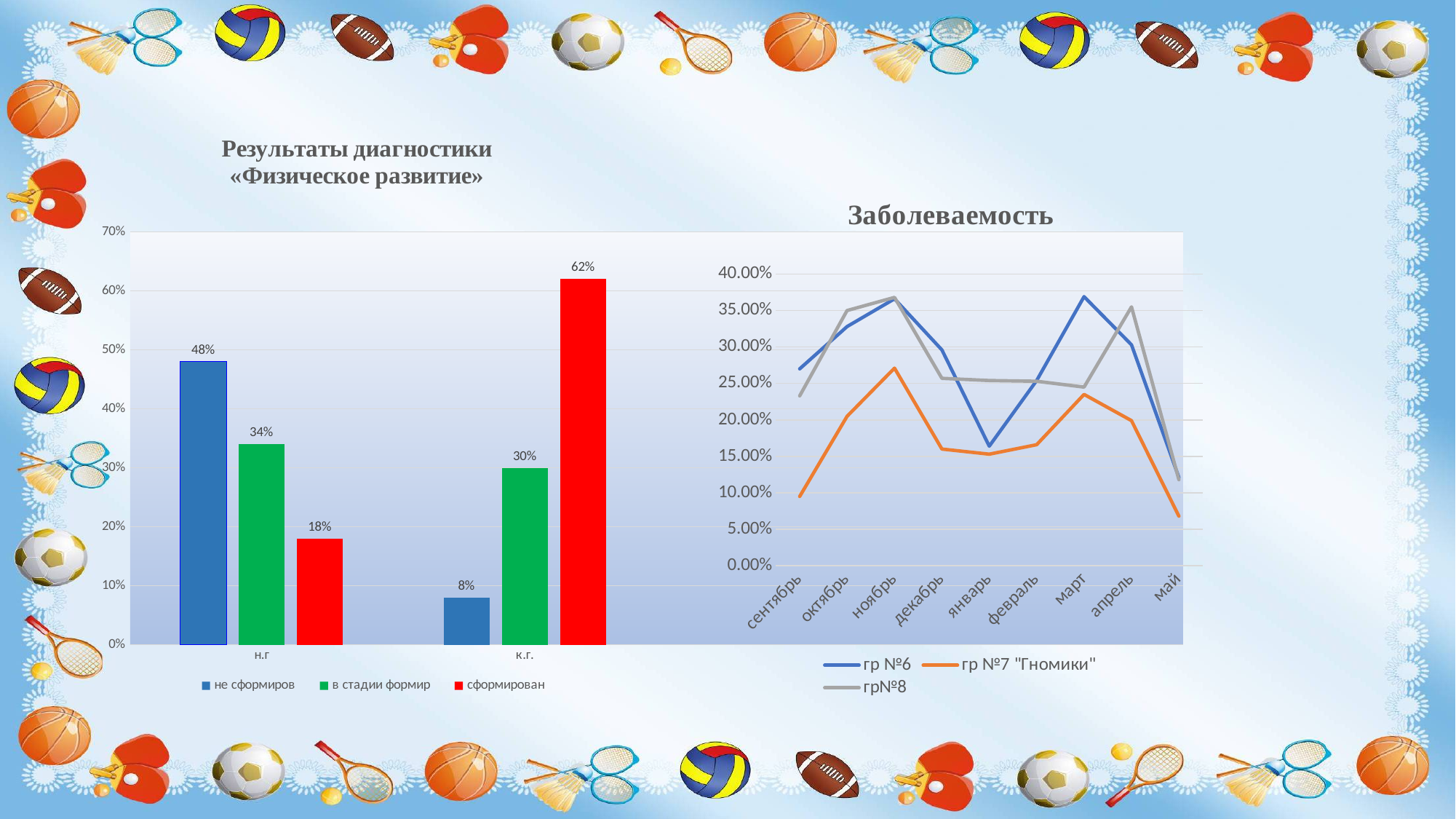
How many months are shown on the x axis of the chart «Заболеваемость»? 9 In the chart «Результаты диагностики «Физическое развитие»», which series has the lowest value at к.г.? не сформиров In the chart «Заболеваемость», is the value for гр №6 in март greater or less than 30.00%? greater In the chart «Заболеваемость», is the value for гр №7 "Гномики" in май greater or less than 10.00%? less What kind of chart is «Результаты диагностики «Физическое развитие»»? bar chart In the chart «Результаты диагностики «Физическое развитие»», which is larger: «в стадии формир» at н.г or «в стадии формир» at к.г.? в стадии формир at н.г In the chart «Результаты диагностики «Физическое развитие»», what is the value for «не сформиров» at н.г? 48% In the chart «Результаты диагностики «Физическое развитие»», what is the value for «в стадии формир» at к.г.? 30% What kind of chart is «Заболеваемость»? line chart In the chart «Результаты диагностики «Физическое развитие»», what is the difference between «сформирован» at к.г. and «сформирован» at н.г? 44% How many series does the legend of the chart «Результаты диагностики «Физическое развитие»» list? 3 In the chart «Результаты диагностики «Физическое развитие»», what is the value for «сформирован» at к.г.? 62%